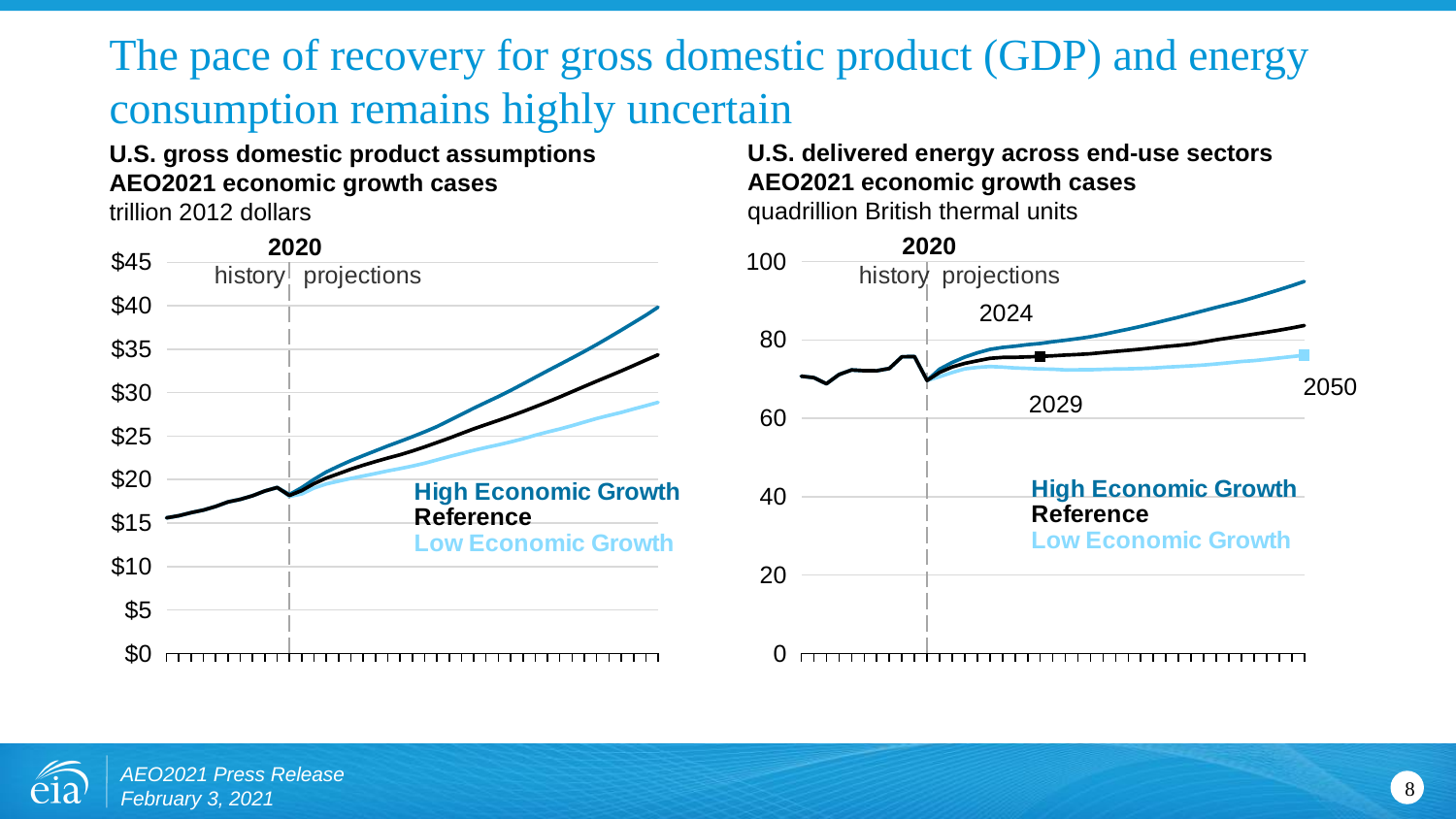
What type of chart is the U.S. gross domestic product assumptions chart on the left? line chart What unit is used on the U.S. gross domestic product assumptions chart? trillion 2012 dollars In the U.S. gross domestic product assumptions chart, is the Low Economic Growth value at the end of the projection greater or less than $25? greater In the U.S. delivered energy across end-use sectors chart, is the Low Economic Growth value in 2050 greater or less than 80? less In the U.S. gross domestic product assumptions chart, which series is higher at the end of the projection, High Economic Growth or Low Economic Growth? High Economic Growth In the U.S. delivered energy across end-use sectors chart, which series is highest at the end of the projection? High Economic Growth How many series are shown in the U.S. delivered energy across end-use sectors chart on the right? 3 In the U.S. gross domestic product assumptions chart, is the Reference value at the end of the projection greater or less than $30? greater In the U.S. delivered energy across end-use sectors chart, which series is lowest at the end of the projection? Low Economic Growth In the U.S. gross domestic product assumptions chart, does the High Economic Growth line rise or fall over the projection period? rise In which year does the dashed vertical line separating history from projections fall on both charts? 2020